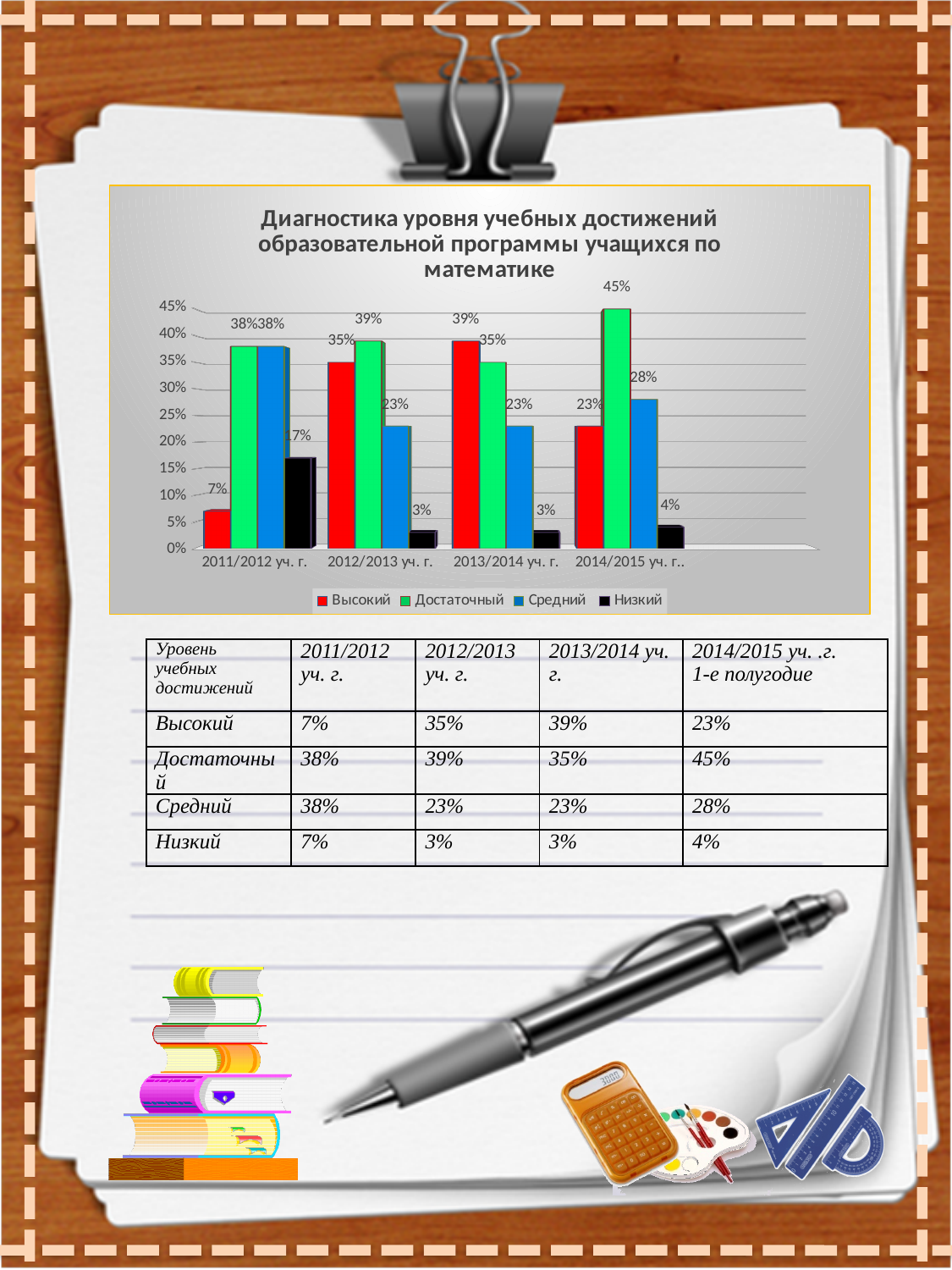
How many school-year categories are shown on the x axis of the chart? 4 In which school year is the Достаточный value lowest? 2013/2014 уч. г. In which school year is the Высокий value highest? 2013/2014 уч. г. What is the difference between the Достаточный value in 2014/2015 уч. г. and in 2013/2014 уч. г.? 10% Which is larger in 2012/2013 уч. г.: the Высокий value or the Средний value? Высокий What kind of chart is shown on the slide? bar chart What is the title of the chart? Диагностика уровня учебных достижений образовательной программы учащихся по математике What is the value for Низкий in 2013/2014 уч. г.? 3% How many series does the chart legend list? 4 What is the value for Высокий in 2011/2012 уч. г.? 7% What is the value for Средний in 2012/2013 уч. г.? 23% What is the value for Достаточный in 2014/2015 уч. г.? 45%